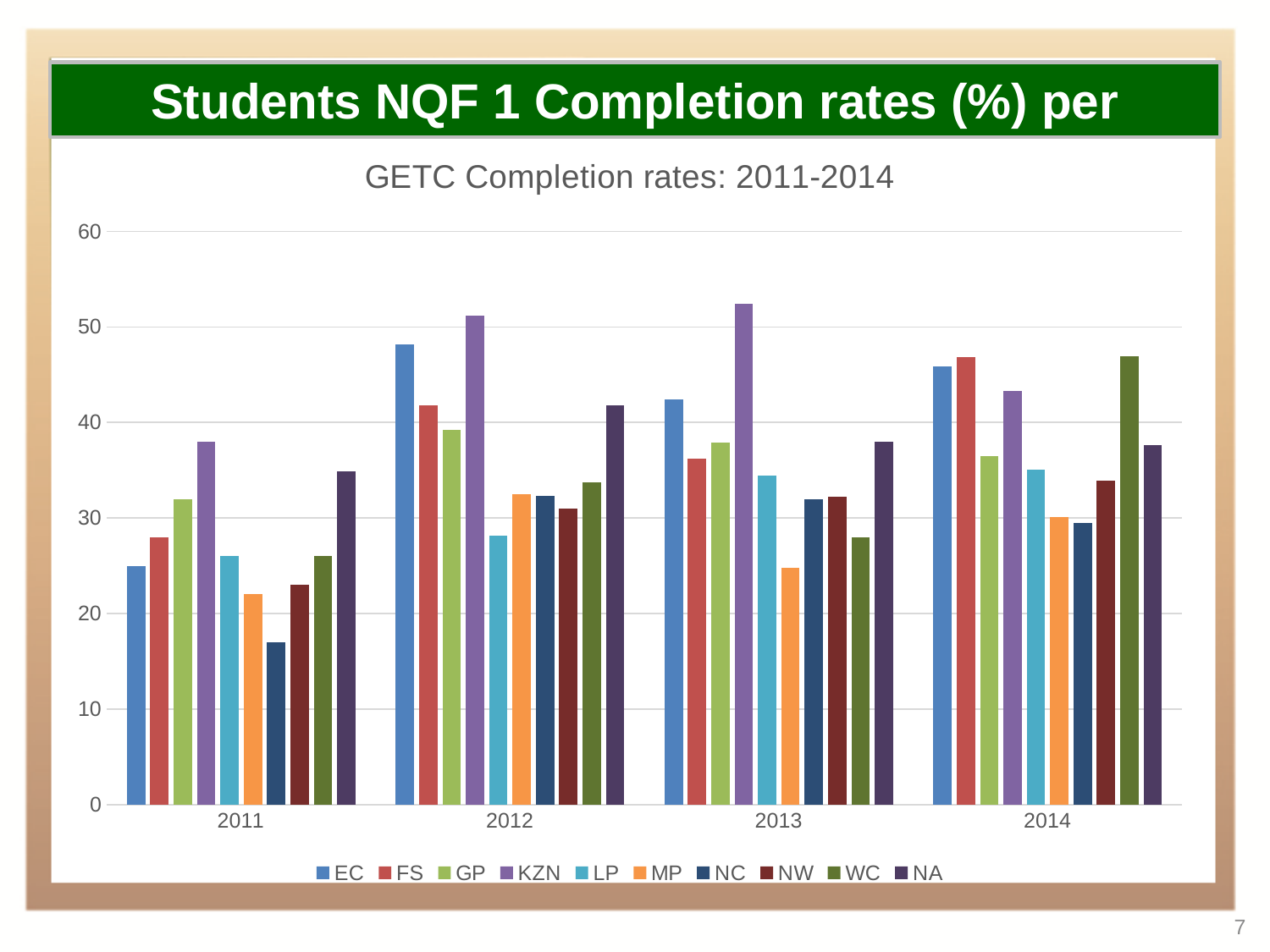
Which is larger, the value for EC in 2011 or the value for EC in 2012? EC in 2012 Which province has the highest completion rate in 2011? KZN How many series does the legend list? 10 Is the value for EC in 2012 greater or less than 40? greater What kind of chart is shown on the slide? bar chart What is the title printed above the chart area? GETC Completion rates: 2011-2014 Which province has the lowest completion rate in 2013? MP Which province has the highest completion rate in 2013? KZN Which province has the lowest completion rate in 2011? NC Does the value for MP rise or fall from 2012 to 2013? fall Is the value for NC in 2011 greater or less than 20? less How many year categories are shown on the x axis? 4